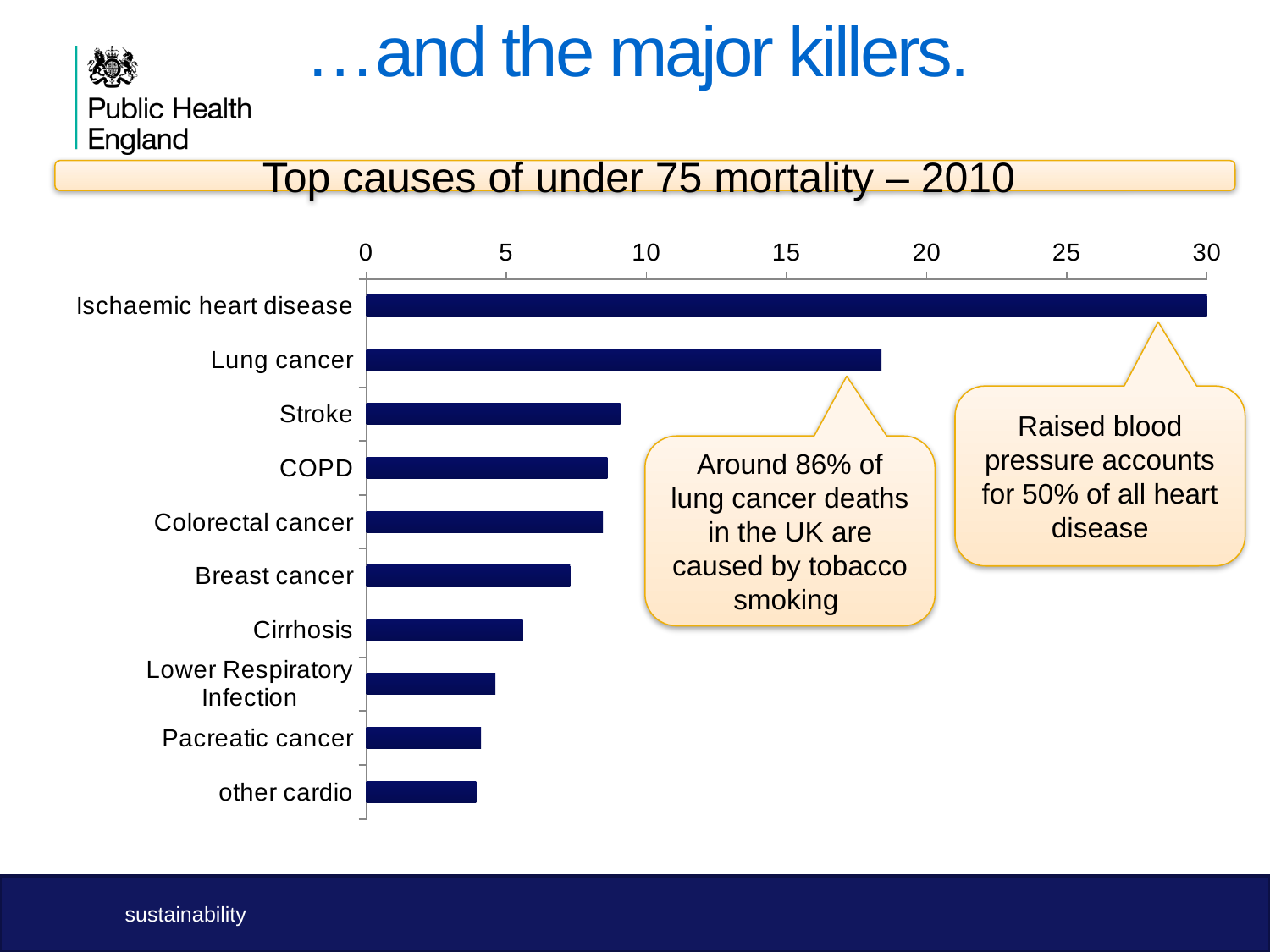
What kind of chart is shown on the slide? Bar chart Which is larger, the value for Breast cancer or the value for Cirrhosis? Breast cancer What is the title of the chart? Top causes of under 75 mortality – 2010 Is the value for Stroke greater or less than 10? less According to the callout on the chart, what percentage of lung cancer deaths in the UK are caused by tobacco smoking? Around 86% Which cause has the highest value on the chart? Ischaemic heart disease Which is larger, the value for Lung cancer or the value for Stroke? Lung cancer Is the value for Lung cancer greater or less than 15? greater Is the value for Lower Respiratory Infection greater or less than 5? less How many causes of death are listed on the chart? 10